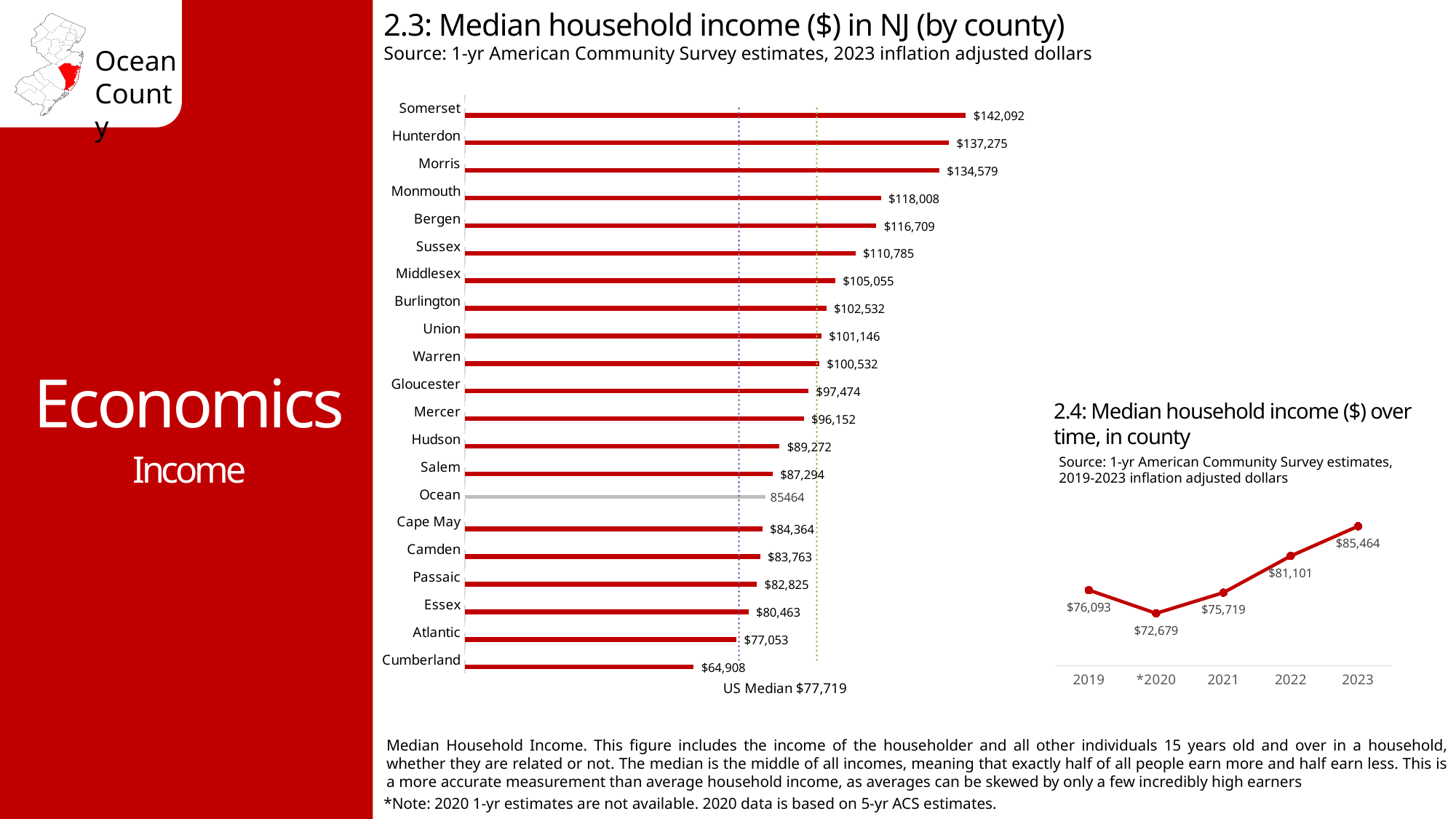
In chart 2.3, which county has the highest median household income? Somerset In chart 2.3, which county has the lowest median household income? Cumberland What kind of chart is chart 2.3? Bar chart In chart 2.4, does the median household income rise or fall from 2020 to 2023? Rise In chart 2.4, which year has the lowest median household income? *2020 In chart 2.4 (Median household income over time, in county), what is the value for 2023? $85,464 In chart 2.3, what is the difference between the median household income of Somerset and Cumberland? $77,184 In chart 2.3, which county has a higher median household income, Bergen or Monmouth? Monmouth In chart 2.3 (Median household income in NJ by county), what is the median household income for Somerset? $142,092 In chart 2.3, what is the median household income for Ocean county? 85464 In chart 2.4, what is the difference between the 2023 and 2019 values? $9,371 In chart 2.3, how many counties are shown? 21